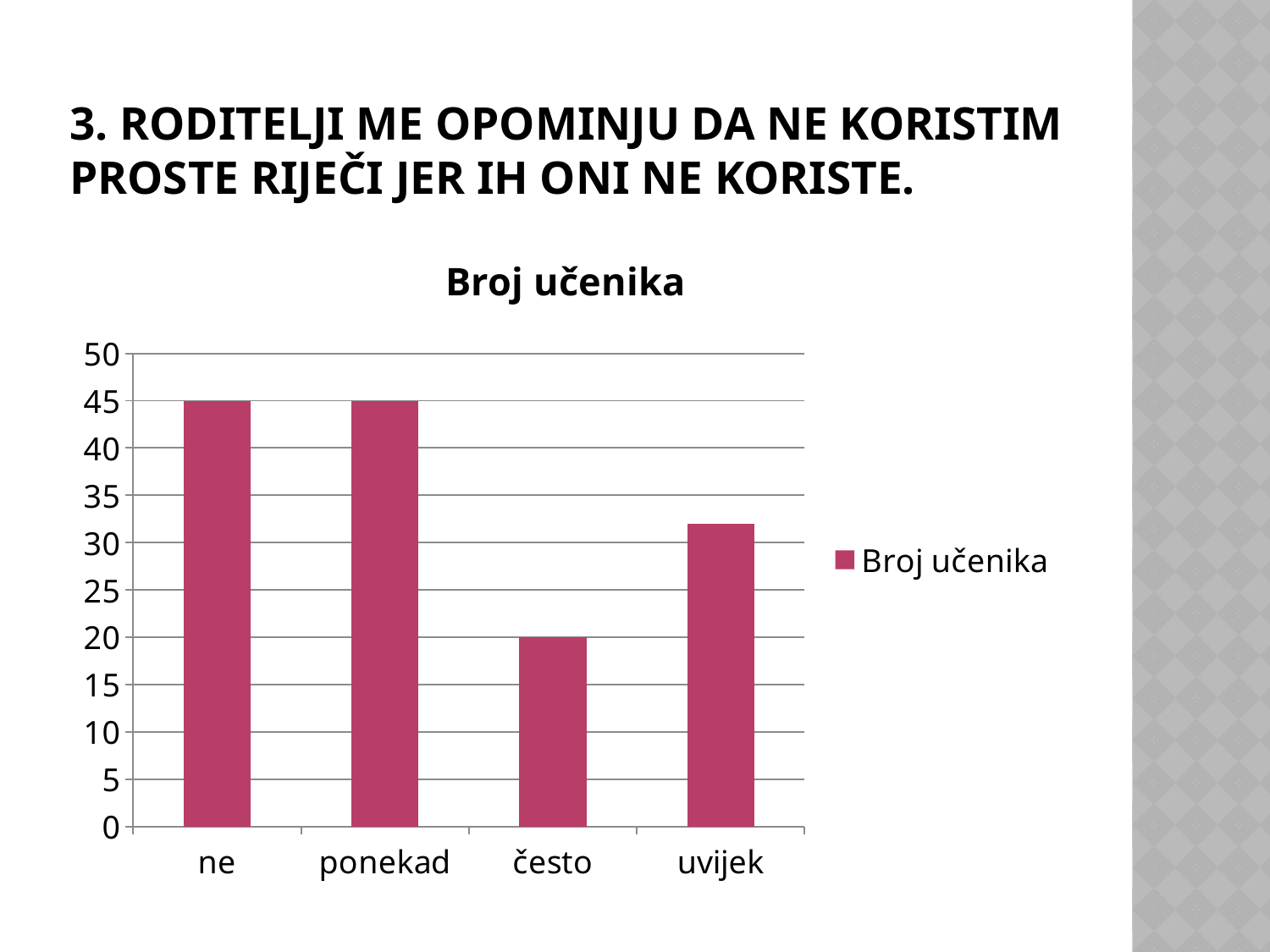
How many categories are shown on the x axis? 4 Is the value for "uvijek" greater or less than 35? less How many series does the legend list? 1 What is the difference between the values for "ne" and "često"? 25 Is the value for "uvijek" greater or less than 30? greater What is the value for "ponekad"? 45 Which is larger, the value for "uvijek" or the value for "često"? uvijek What kind of chart is shown on the slide? bar chart What is the title of the chart? Broj učenika What is the value for "često"? 20 What is the value for "ne"? 45 Which category has the lowest value? često